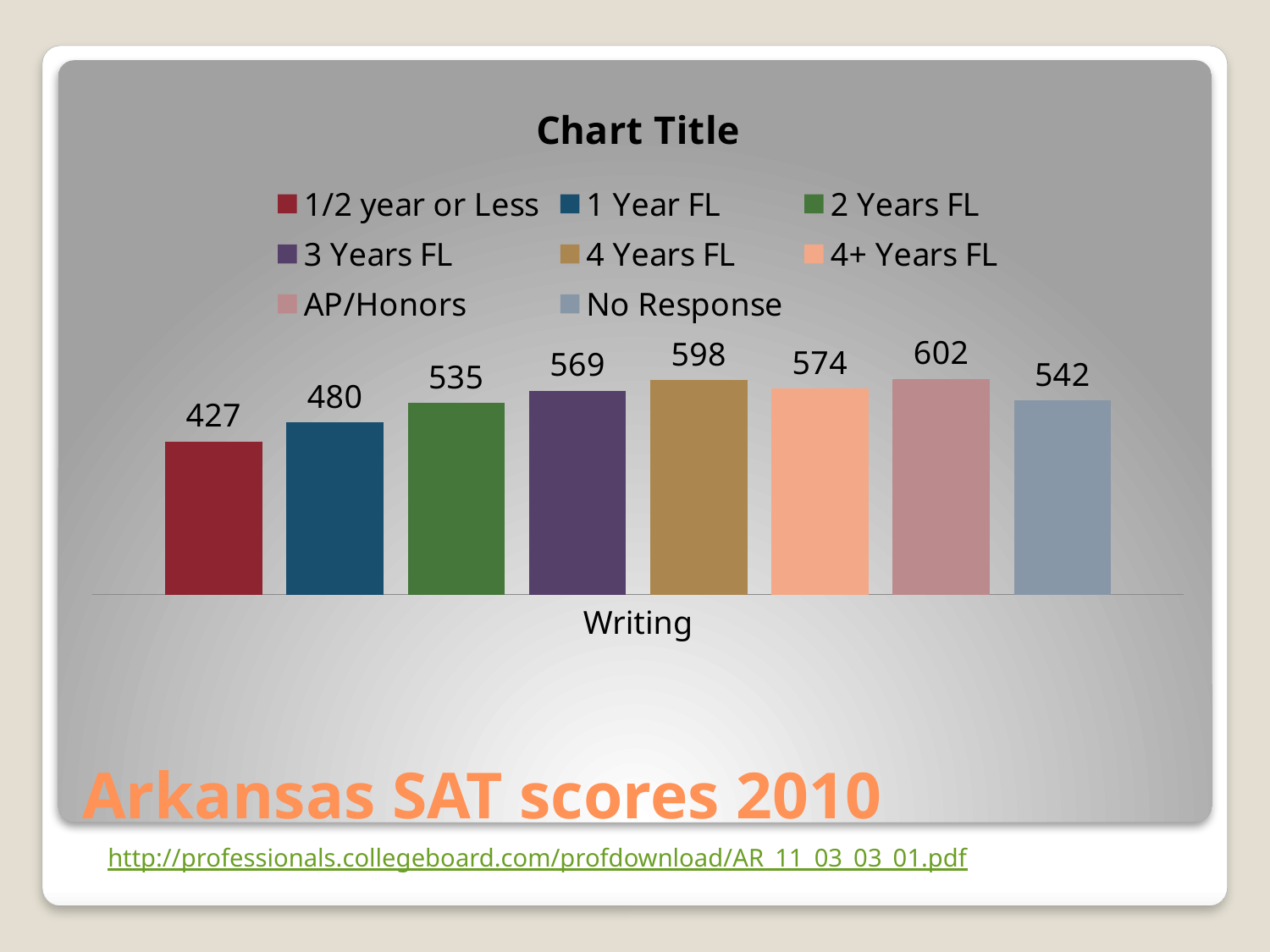
What is the Writing score for the 4 Years FL series? 598 What is the Writing score for the 1/2 year or Less series? 427 Which series has the highest Writing score? AP/Honors What is the Writing score for the No Response series? 542 What is the difference between the Writing scores for 4 Years FL and 4+ Years FL? 24 What is the difference between the Writing scores for AP/Honors and 1/2 year or Less? 175 What is the title shown above the chart? Chart Title What is the category label shown on the x axis? Writing How many series does the legend list? 8 Which series has the lowest Writing score? 1/2 year or Less What kind of chart is shown on the slide? Bar chart Which is larger, the Writing score for 3 Years FL or for No Response? 3 Years FL